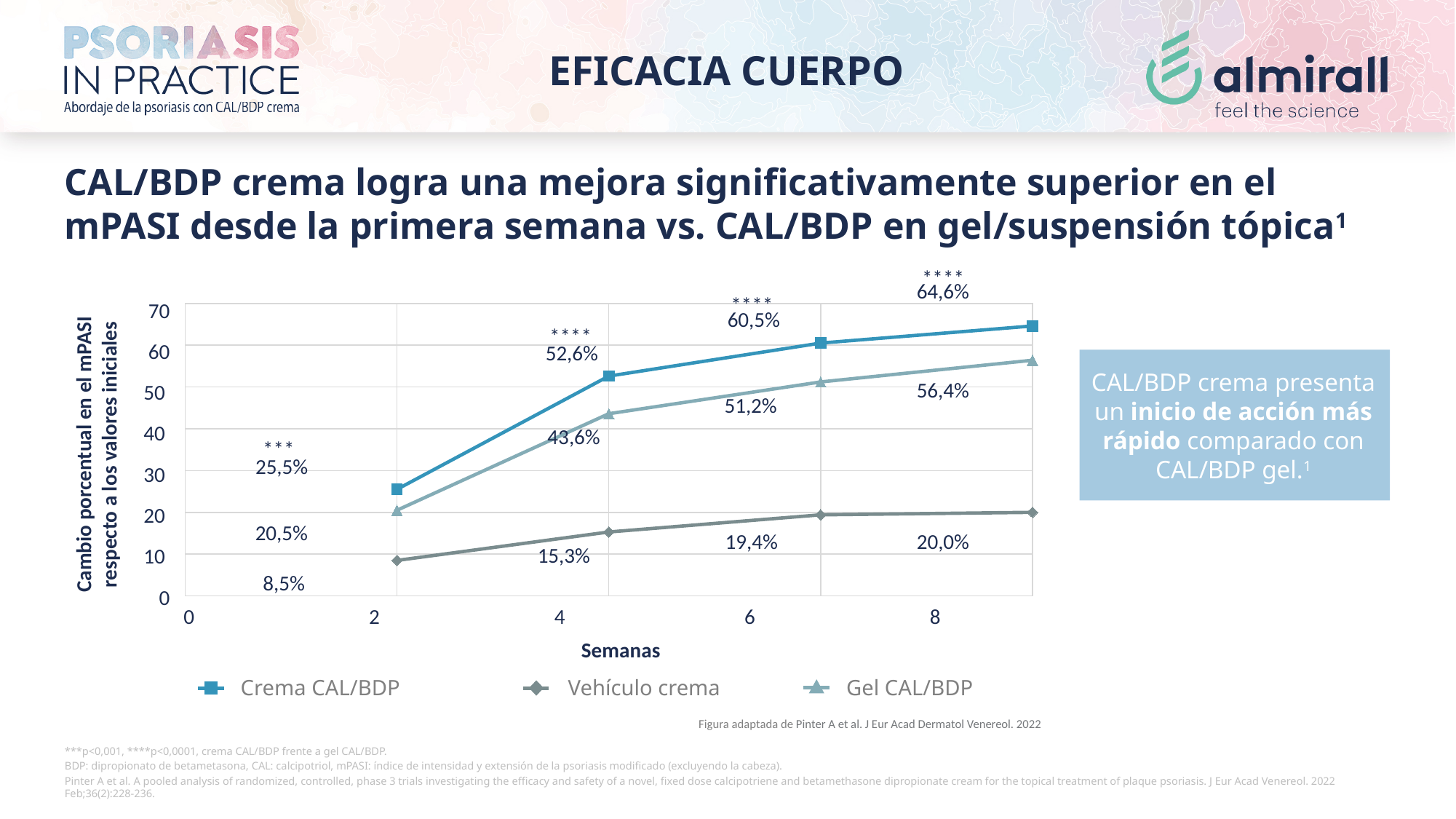
What is the difference between Crema CAL/BDP (64,6%) and Gel CAL/BDP (56,4%) at the last time point? 8,2% Do the values for Crema CAL/BDP rise or fall along the x axis? rise What is the value for Gel CAL/BDP at the first time point on the chart? 20,5% What is the value for Crema CAL/BDP at the last time point on the chart? 64,6% What is the value for Vehículo crema at the second time point on the chart? 15,3% How many data points are plotted for each series? 4 At the second time point, which is larger: Crema CAL/BDP or Gel CAL/BDP? Crema CAL/BDP Which series has the highest value at the last time point? Crema CAL/BDP What is the label of the x axis? Semanas How many series does the legend list? 3 Which series has the lowest value at the first time point? Vehículo crema What type of chart is shown on the slide? line chart